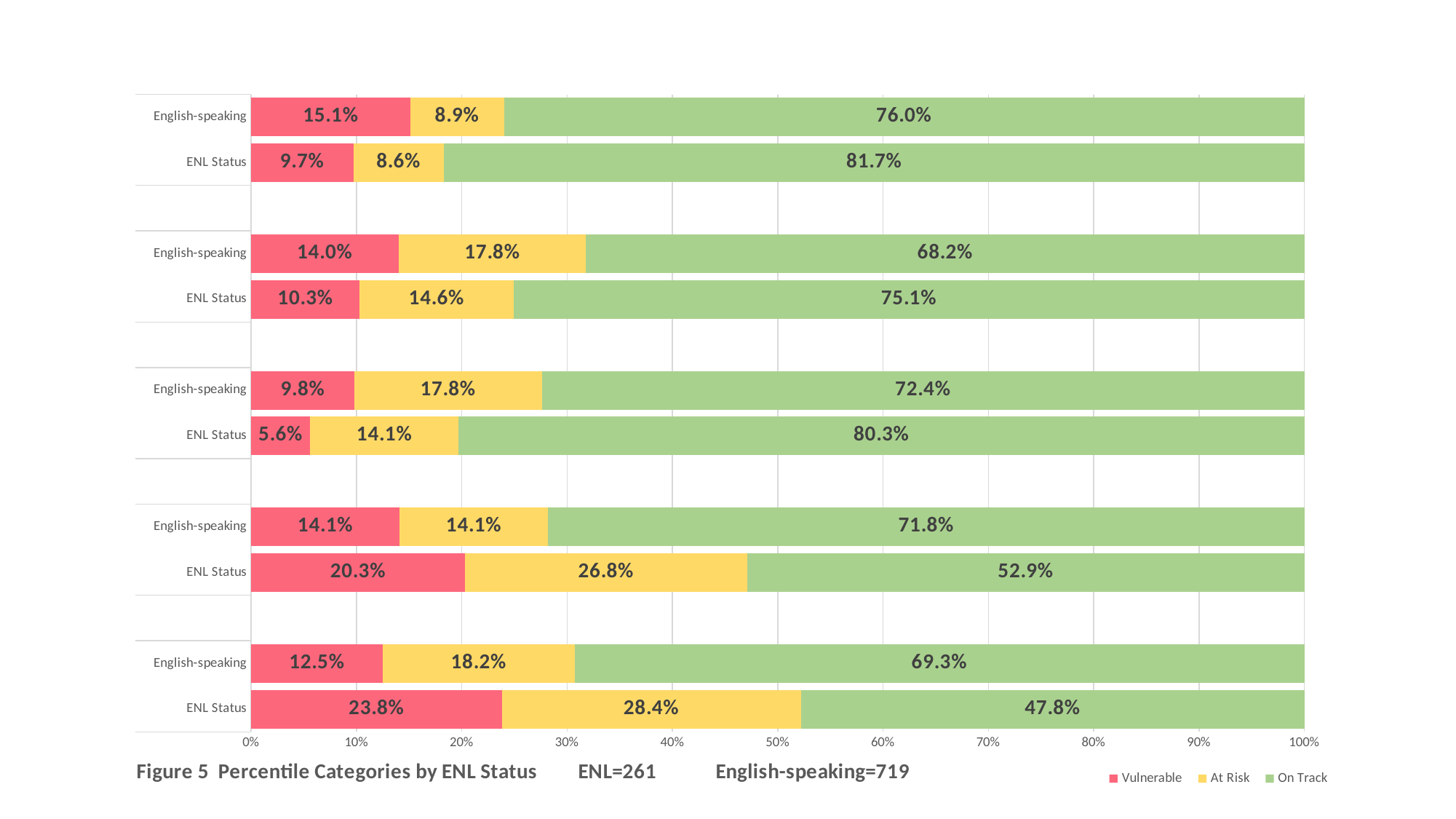
Which colour represents the At Risk series in the legend? Yellow What is the At Risk percentage for the English-speaking bar in the second pair from the top? 17.8% What is the On Track percentage for the ENL Status bar in the topmost pair of bars? 81.7% How many series does the legend list? 3 Which bar has the highest On Track percentage? ENL Status in the topmost pair (81.7%) What is the figure title shown below the chart? Figure 5 Percentile Categories by ENL Status In the fourth pair from the top, which has the larger Vulnerable percentage, English-speaking or ENL Status? ENL Status What kind of chart is shown on the slide? Stacked bar chart How many bars are plotted in the chart? 10 Which bar has the lowest On Track percentage? ENL Status in the bottommost pair (47.8%) What is the Vulnerable percentage for the ENL Status bar in the bottommost pair of bars? 23.8% In the bottommost pair of bars, what is the difference between the On Track percentages of English-speaking and ENL Status? 21.5%